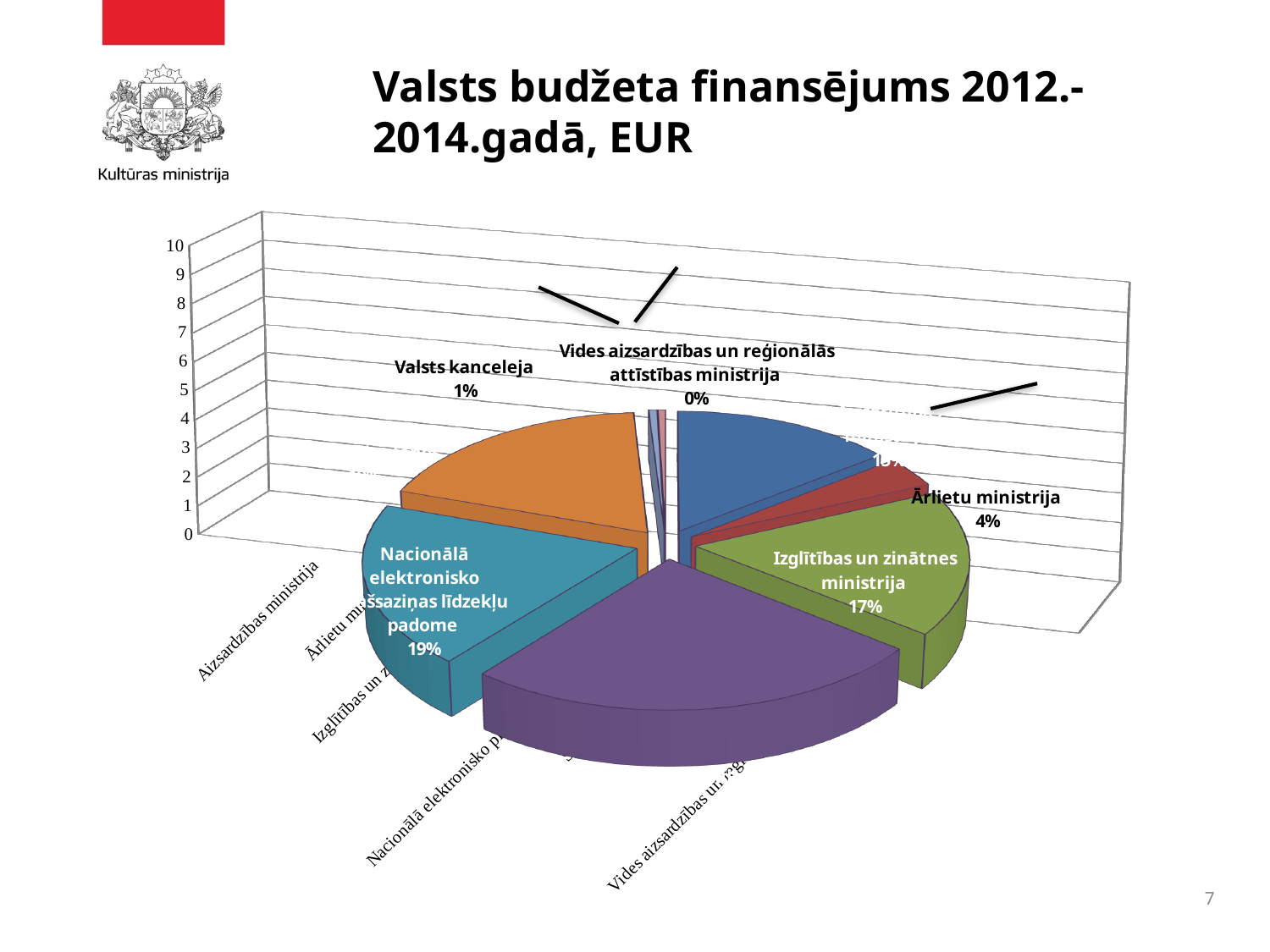
What percentage is shown for Ārlietu ministrija? 4% What share of the pie does Izglītības un zinātnes ministrija have? 17% What share of the pie does Nacionālā elektronisko plašsaziņas līdzekļu padome have? 19% What is the difference in percentage points between Izglītības un zinātnes ministrija (17%) and Ārlietu ministrija (4%)? 13 percentage points What percentage is shown for Vides aizsardzības un reģionālās attīstības ministrija? 0% Which has a larger share: Izglītības un zinātnes ministrija or Ārlietu ministrija? Izglītības un zinātnes ministrija Which slice is labelled with the smallest share, 0%? Vides aizsardzības un reģionālās attīstības ministrija What is the difference in percentage points between Nacionālā elektronisko plašsaziņas līdzekļu padome (19%) and Izglītības un zinātnes ministrija (17%)? 2 percentage points What percentage is shown for Valsts kanceleja? 1% Which has a larger share: Nacionālā elektronisko plašsaziņas līdzekļu padome or Izglītības un zinātnes ministrija? Nacionālā elektronisko plašsaziņas līdzekļu padome What is the title of the slide? Valsts budžeta finansējums 2012.-2014.gadā, EUR What kind of chart is shown on the slide? Pie chart